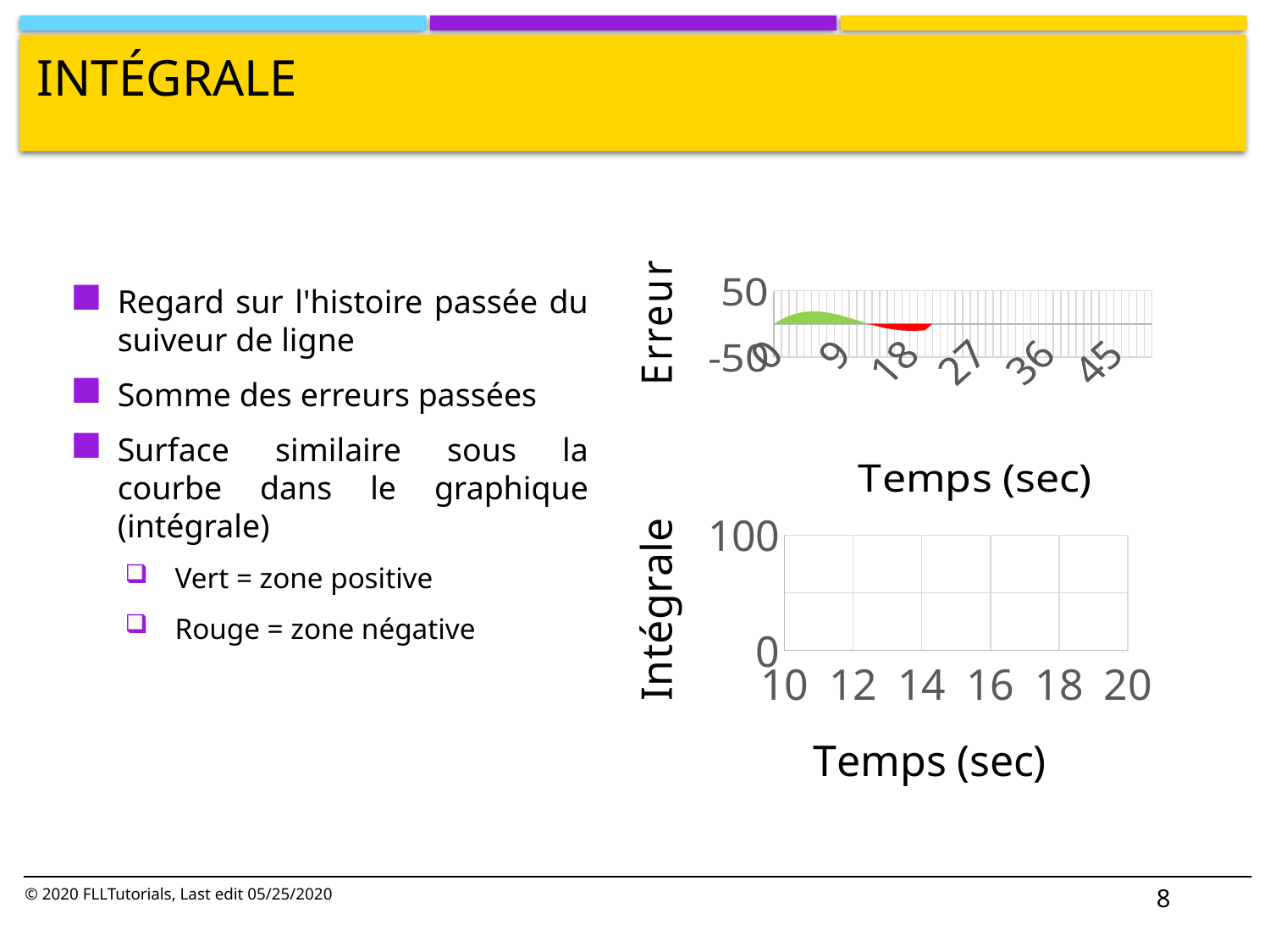
How many tick labels are shown on the x axis of the bottom chart (Intégrale)? 6 In the top chart (Erreur), which is larger, the value at 9 seconds or the value at 18 seconds? 9 seconds In the top chart (Erreur), is the value at 9 seconds positive or negative? positive In the top chart (Erreur), is the value at 18 seconds greater or less than -50? greater In the top chart (Erreur), is the value at 18 seconds positive or negative? negative What kind of chart is the top chart labelled "Erreur"? area chart In the top chart (Erreur), does the error rise or fall between 9 and 18 seconds? fall How many tick labels are shown on the x axis of the top chart (Erreur)? 6 What colour is the positive area in the top chart (Erreur)? green What is the x-axis title of the bottom chart (Intégrale)? Temps (sec)